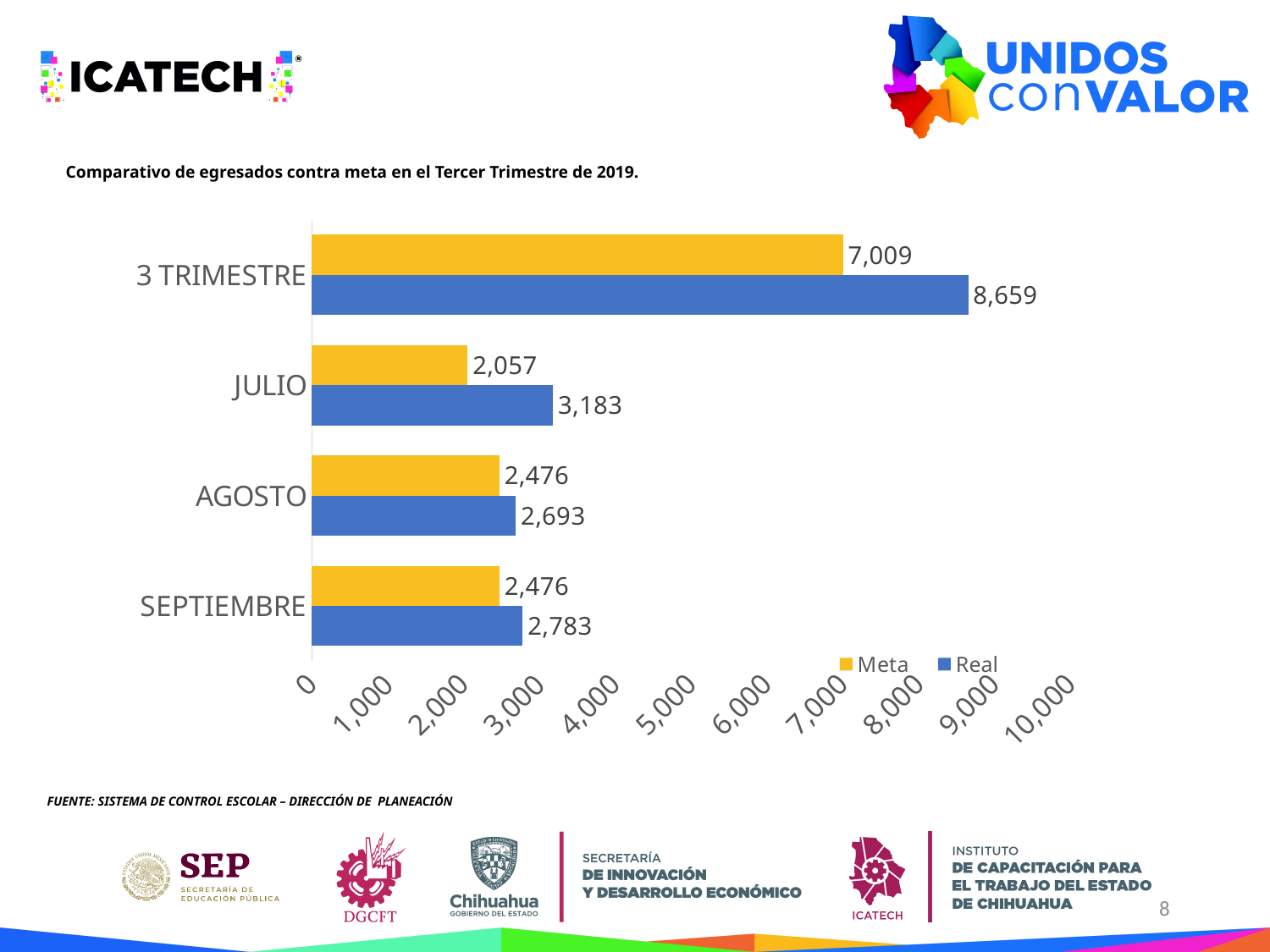
What is the Meta value for 3 TRIMESTRE? 7,009 Which category has the lowest Meta value? JULIO What kind of chart is shown on the slide? Bar chart Which category has the highest Real value? 3 TRIMESTRE What is the Real value for SEPTIEMBRE? 2,783 How many categories are shown on the chart? 4 What is the Real value for JULIO? 3,183 Which colour represents the Meta series? Yellow What is the difference between the Real and Meta values for AGOSTO? 217 Which is larger for JULIO, the Meta value or the Real value? Real How many series does the legend list? 2 What is the difference between the Real and Meta values for 3 TRIMESTRE? 1,650